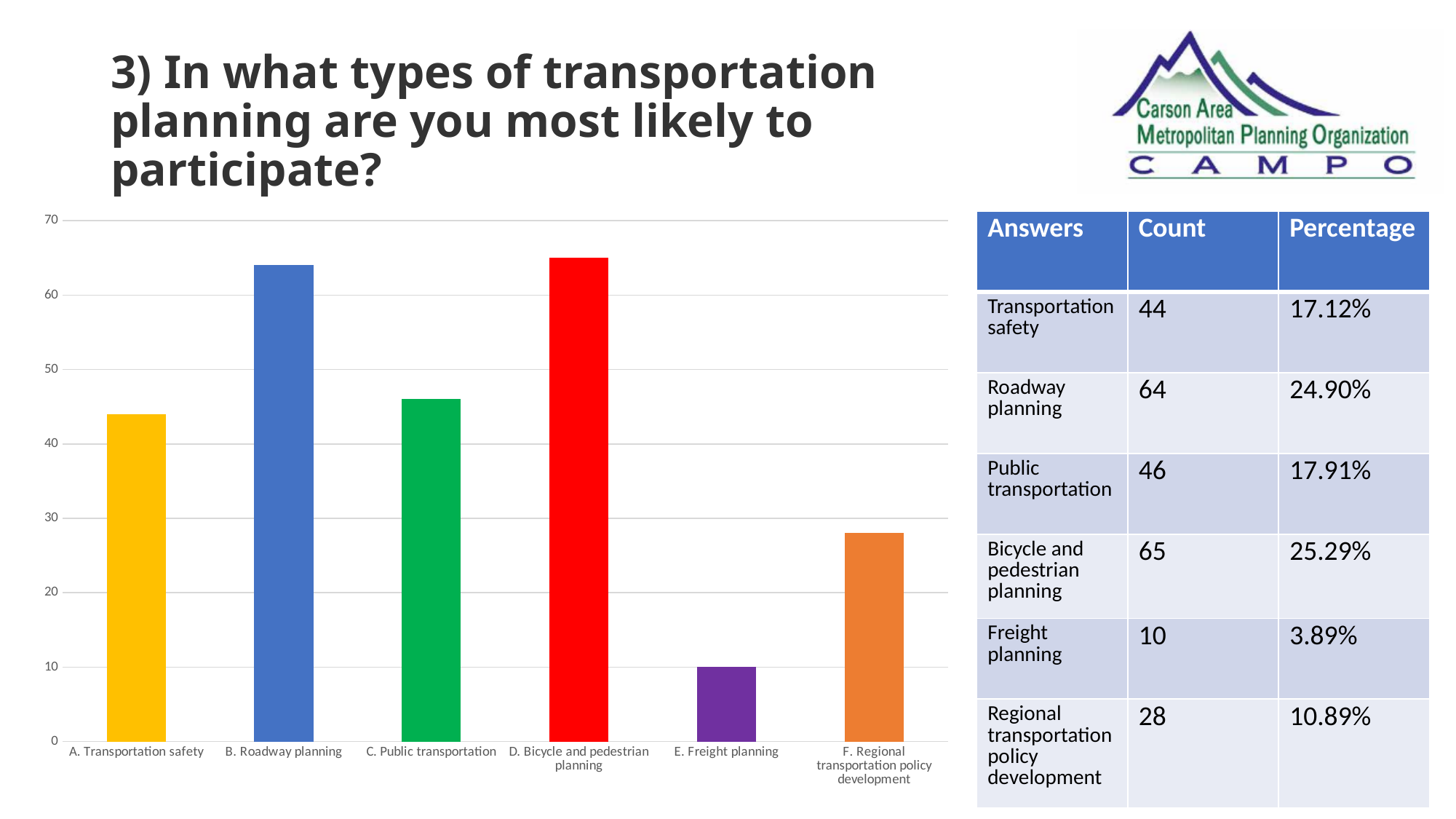
What is the count for Freight planning? 10 How many categories does the bar chart show? 6 What colour is the bar for D. Bicycle and pedestrian planning? red What percentage is shown for Bicycle and pedestrian planning? 25.29% What is the count for Roadway planning? 64 Which is larger, the value for B. Roadway planning or the value for C. Public transportation? B. Roadway planning What is the difference between the counts for Public transportation and Transportation safety? 2 Is the value for A. Transportation safety greater or less than 40? greater What is the count for Regional transportation policy development? 28 What kind of chart is shown on the slide? bar chart Is the value for F. Regional transportation policy development greater or less than 30? less Which category has the lowest value in the bar chart? E. Freight planning